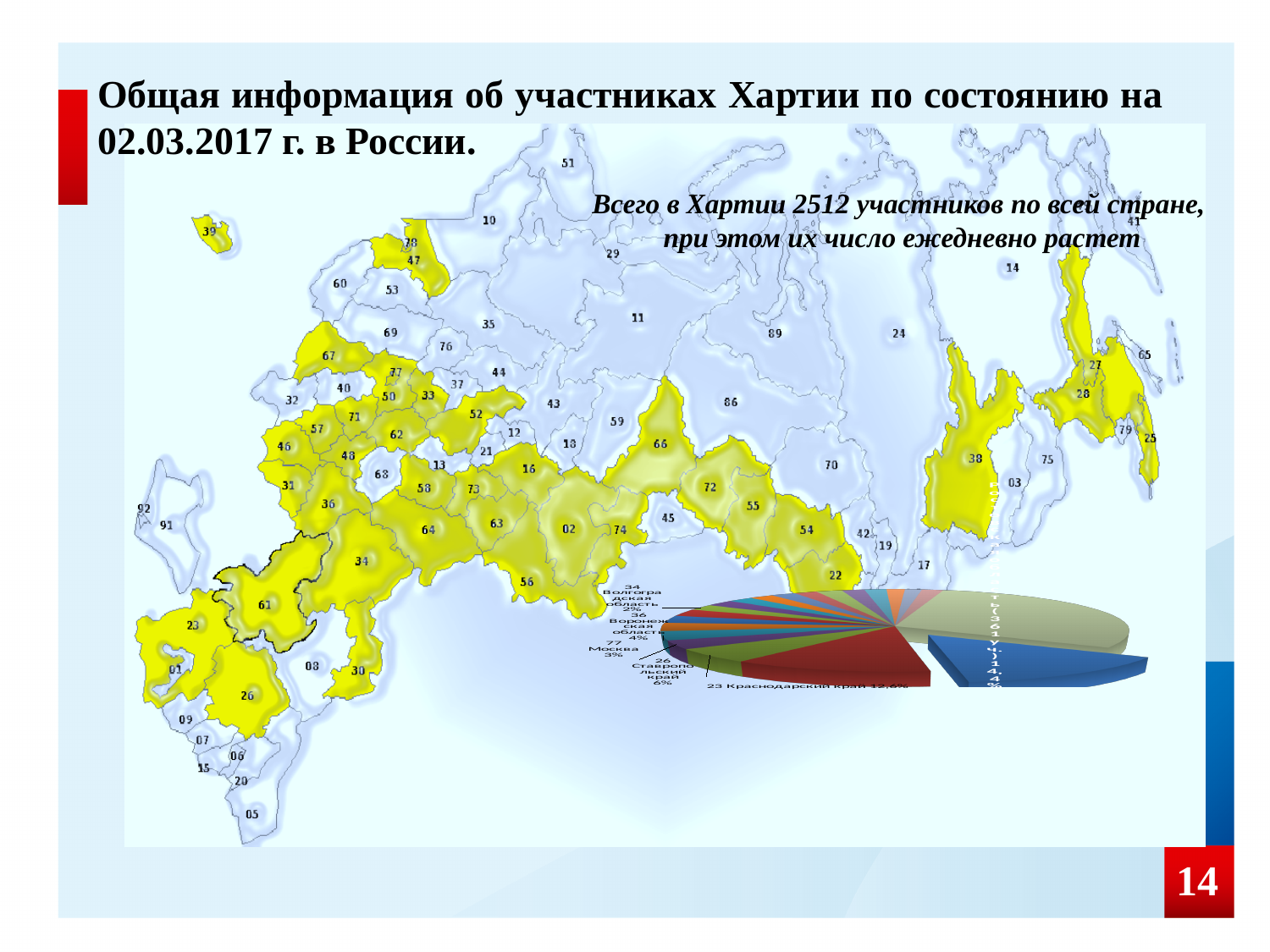
In the pie chart, what share is labelled for Ставропольский край? 6% In the pie chart, what share is labelled for Волгоградская область? 2% What kind of chart is shown in the lower right of the slide? pie chart In the pie chart, what is the difference between the shares of Воронежская область and Волгоградская область? 2% In the pie chart, what share is labelled for Краснодарский край? 12,6% In the pie chart, what share is labelled for Москва? 3% In the pie chart, what is the difference between the shares of Ставропольский край and Москва? 3% In the pie chart, which region code is shown next to the label Москва? 77 In the pie chart, what is the difference between the shares of Краснодарский край and Ставропольский край? 6,6% In the pie chart, which has the larger share: Краснодарский край or Ставропольский край? Краснодарский край In the pie chart, which has the larger share: Воронежская область or Волгоградская область? Воронежская область In the pie chart, what share is labelled for Воронежская область? 4%